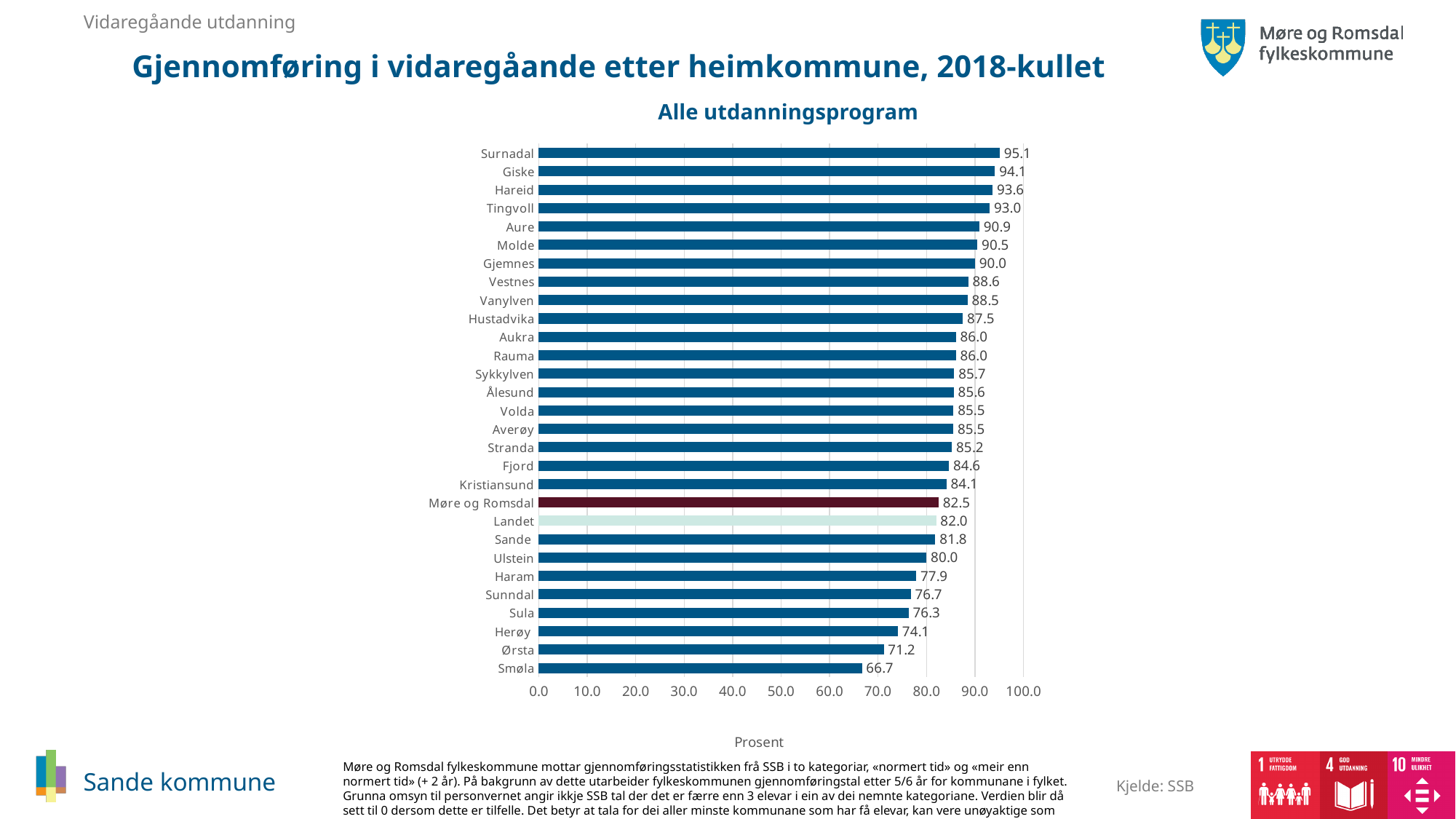
What is the value for Landet? 82.0 What is the title shown above the chart? Alle utdanningsprogram Is the value for Herøy greater or less than 80.0? less What is the value for Sande? 81.8 What is the difference between the values for Surnadal and Smøla? 28.4 Which municipality has the highest value? Surnadal Which has a larger value, Molde or Ålesund? Molde What is the value for Møre og Romsdal? 82.5 What is the difference between the values for Møre og Romsdal and Sande? 0.7 What kind of chart is shown on the slide? Bar chart How many bars are shown in the chart? 29 Which municipality has the lowest value? Smøla